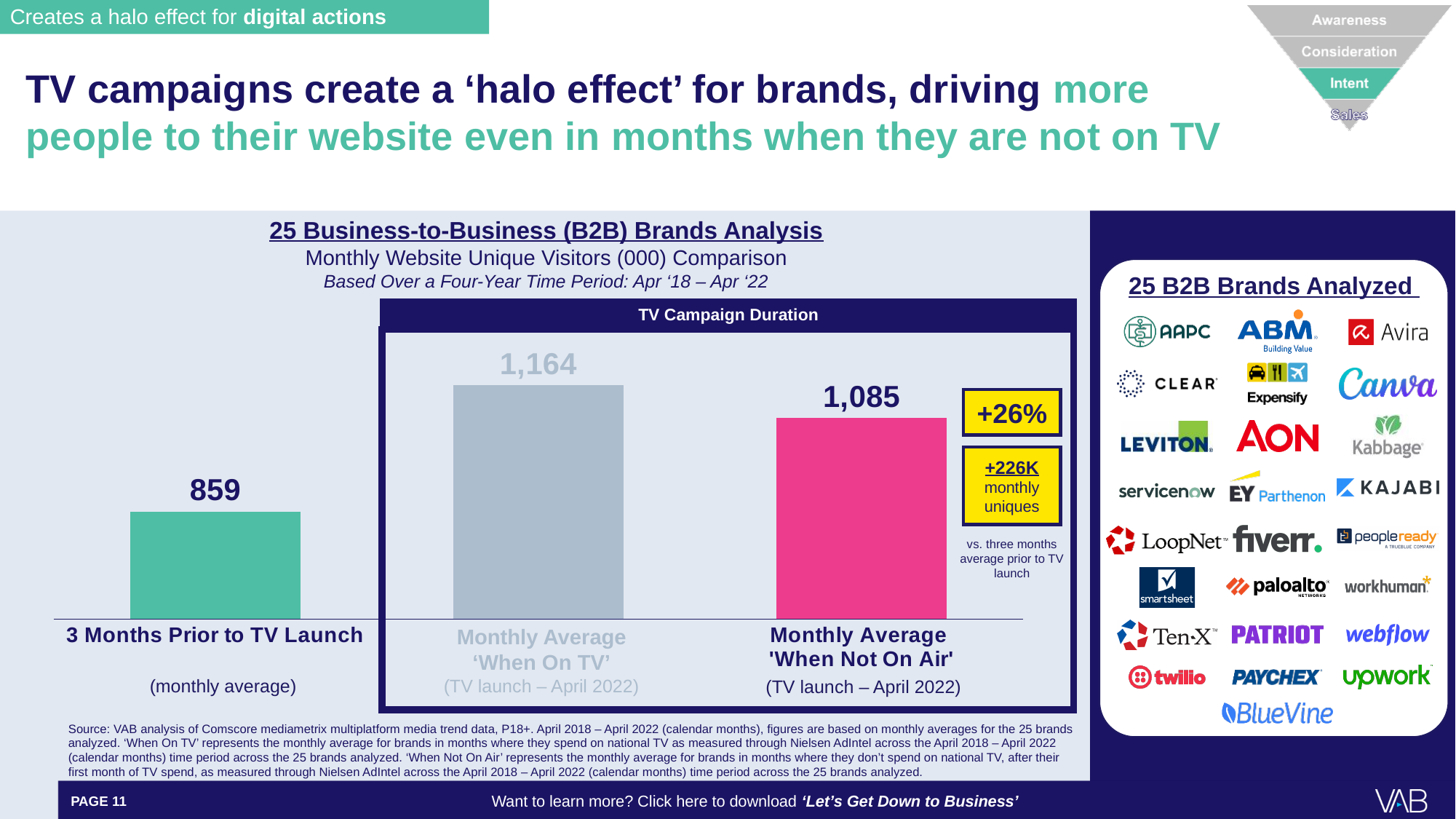
Which category has the highest value on the chart? Monthly Average 'When On TV' What is the Monthly Average 'When On TV' value shown on the chart? 1,164 What is the difference between the Monthly Average 'When On TV' value and the Monthly Average 'When Not On Air' value? 79 What is the monthly average of website unique visitors (000) for the 3 Months Prior to TV Launch? 859 How many bars are plotted on the chart? 3 Which category has the lowest value on the chart? 3 Months Prior to TV Launch What is the Monthly Average 'When Not On Air' value shown on the chart? 1,085 What percentage increase is shown in the yellow callout box next to the 'When Not On Air' bar? +26% What type of chart is shown on the slide? Bar chart What is the title of the chart on the slide? 25 Business-to-Business (B2B) Brands Analysis Which is larger: the Monthly Average 'When On TV' value or the Monthly Average 'When Not On Air' value? Monthly Average 'When On TV' What is the difference between the Monthly Average 'When Not On Air' value and the 3 Months Prior to TV Launch value? 226